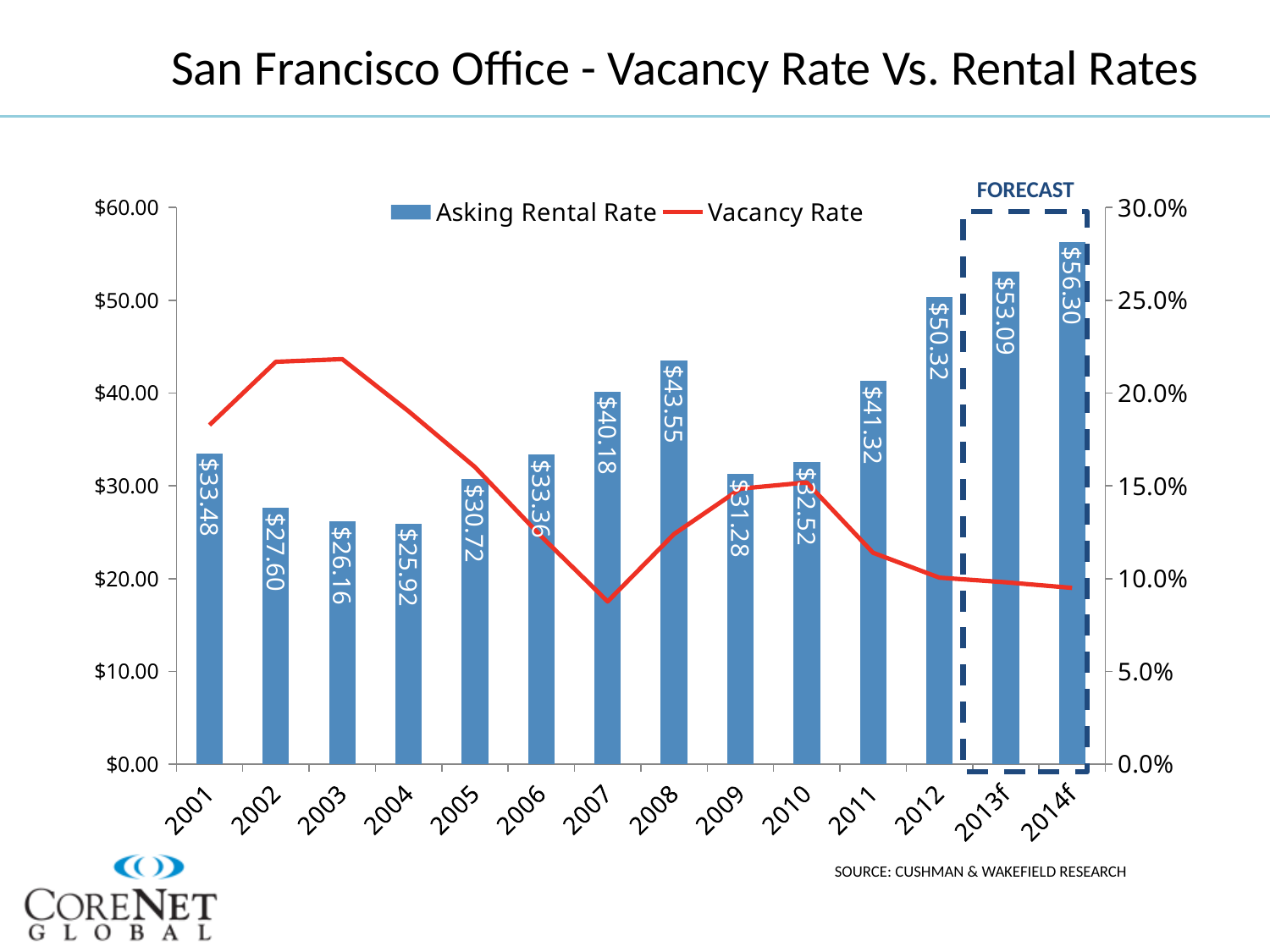
How many years are shown on the x axis? 14 Which year has the lowest Asking Rental Rate? 2004 Is the Vacancy Rate for 2007 greater or less than 10.0%? less Which year has the highest Asking Rental Rate? 2014f What kind of chart is shown on the slide? Combined bar and line chart What is the Asking Rental Rate for 2012? $50.32 Which year has a higher Asking Rental Rate, 2007 or 2011? 2011 Is the Vacancy Rate for 2002 greater or less than 20.0%? greater What is the Asking Rental Rate for 2008? $43.55 What is the difference between the Asking Rental Rate in 2014f and in 2012? $5.98 How many series does the legend list? 2 What is the forecast Asking Rental Rate for 2013f? $53.09